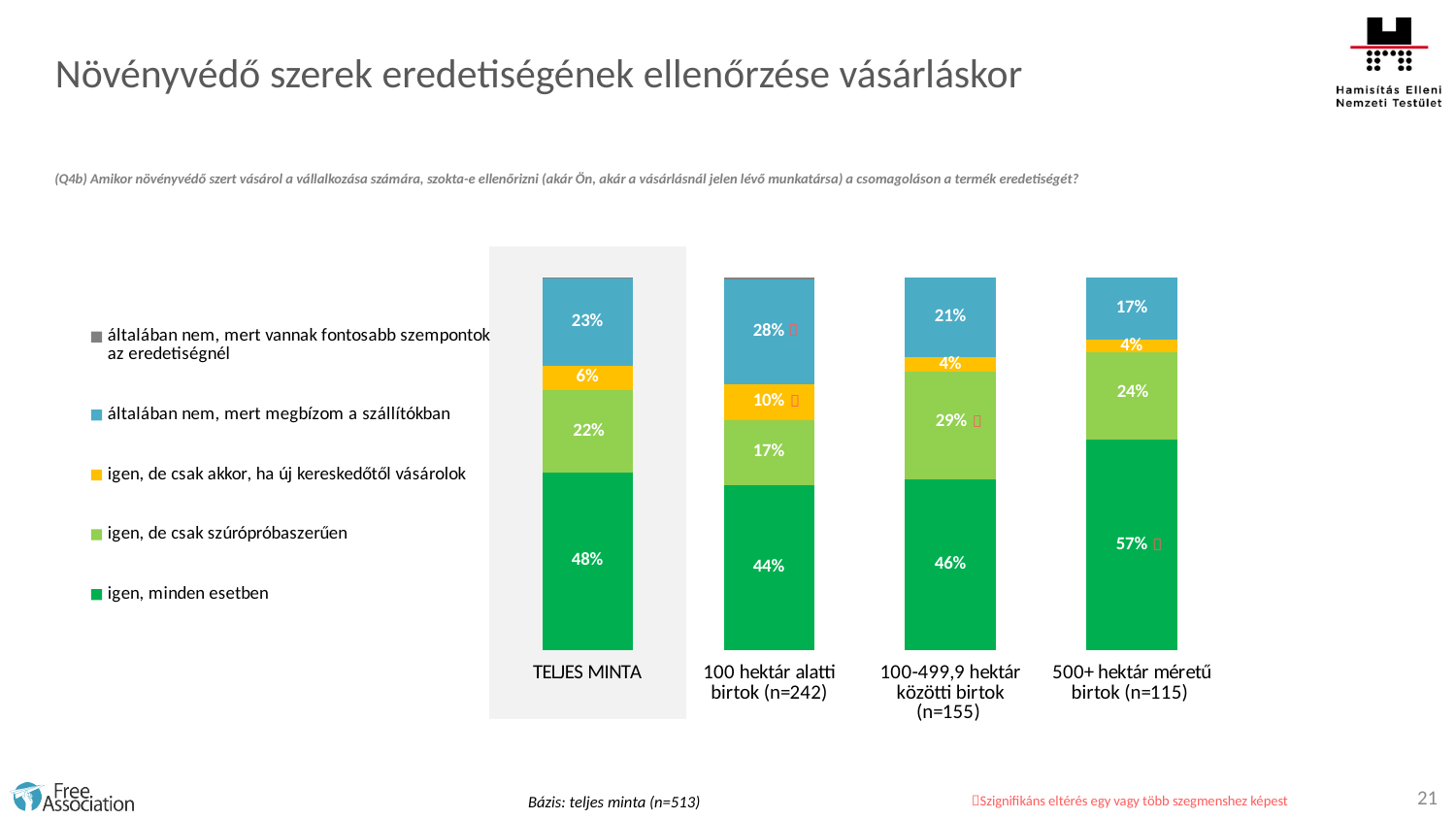
What is the value for 'igen, minden esetben' in the '500+ hektár méretű birtok (n=115)' bar? 57% How many categories (bars) are shown on the x axis? 4 What is the value for 'általában nem, mert megbízom a szállítókban' in the '100 hektár alatti birtok (n=242)' bar? 28% What kind of chart is shown on the slide? stacked bar chart What is the difference between the 'igen, minden esetben' values for '500+ hektár méretű birtok (n=115)' and '100 hektár alatti birtok (n=242)'? 13 percentage points Which category has the highest value for 'igen, minden esetben'? 500+ hektár méretű birtok (n=115) How many series does the legend list? 5 Which category has the lowest value for 'igen, minden esetben'? 100 hektár alatti birtok (n=242) What is the value for 'igen, de csak szúrópróbaszerűen' in the '100-499,9 hektár közötti birtok (n=155)' bar? 29% Which is larger: the 'igen, de csak akkor, ha új kereskedőtől vásárolok' value for '100 hektár alatti birtok (n=242)' or for '100-499,9 hektár közötti birtok (n=155)'? 100 hektár alatti birtok (n=242) What is the value for 'igen, minden esetben' in the TELJES MINTA bar? 48% What is the value for 'igen, de csak akkor, ha új kereskedőtől vásárolok' in the TELJES MINTA bar? 6%